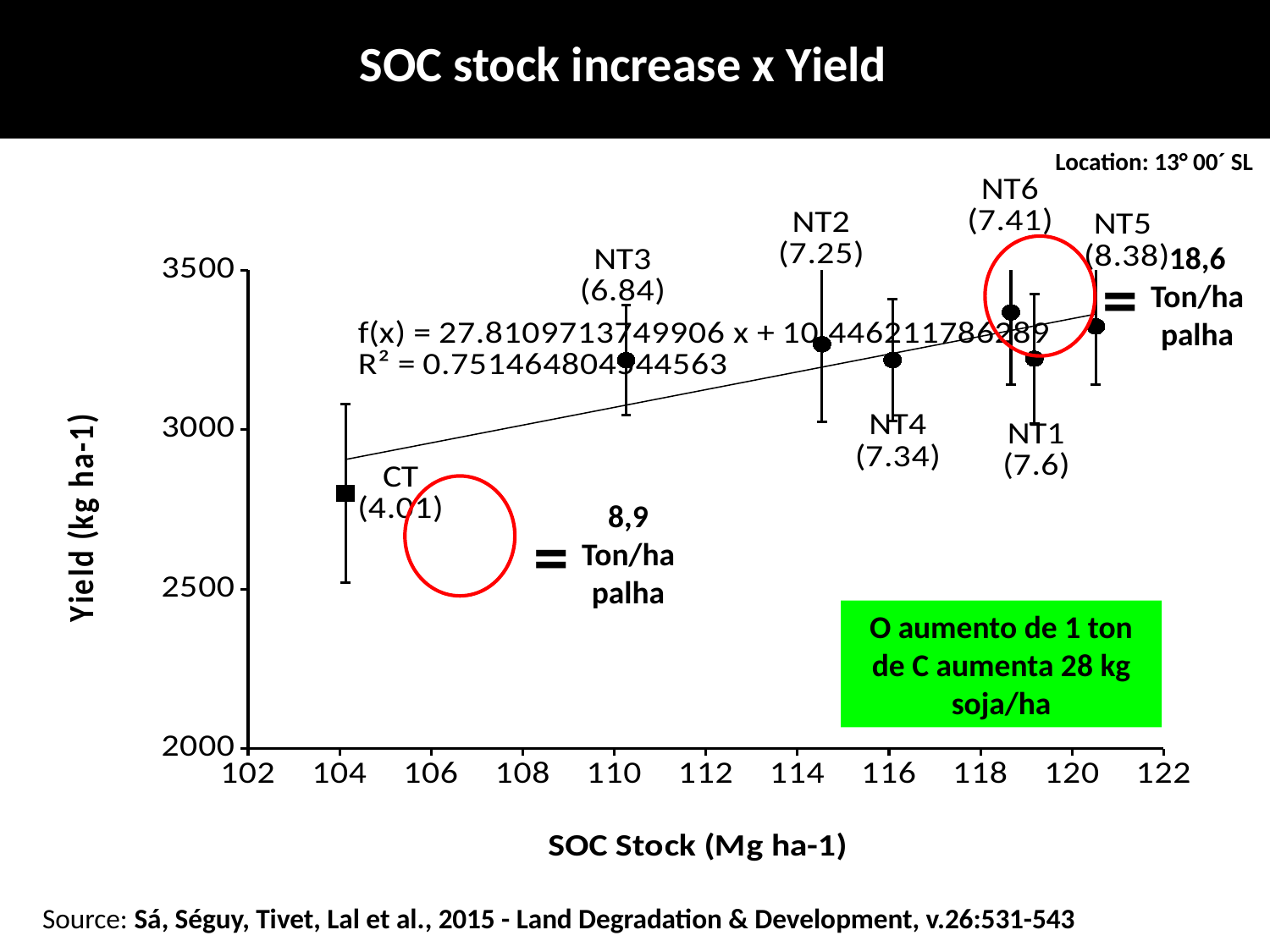
What kind of chart is shown on the slide? Scatter plot Does yield rise or fall as SOC stock increases along the x axis? rise What value is printed in parentheses next to the CT point? 4.01 What value is printed in parentheses next to the NT5 point? 8.38 What is the title of the chart? SOC stock increase x Yield Is the SOC stock for CT greater or less than 106? less Which point has the highest SOC stock? NT5 How many data points are plotted on the chart? 7 What value is printed in parentheses next to the NT3 point? 6.84 Which point has the lowest yield? CT Is the yield for CT greater or less than 3000? less What is the label of the y axis? Yield (kg ha-1)